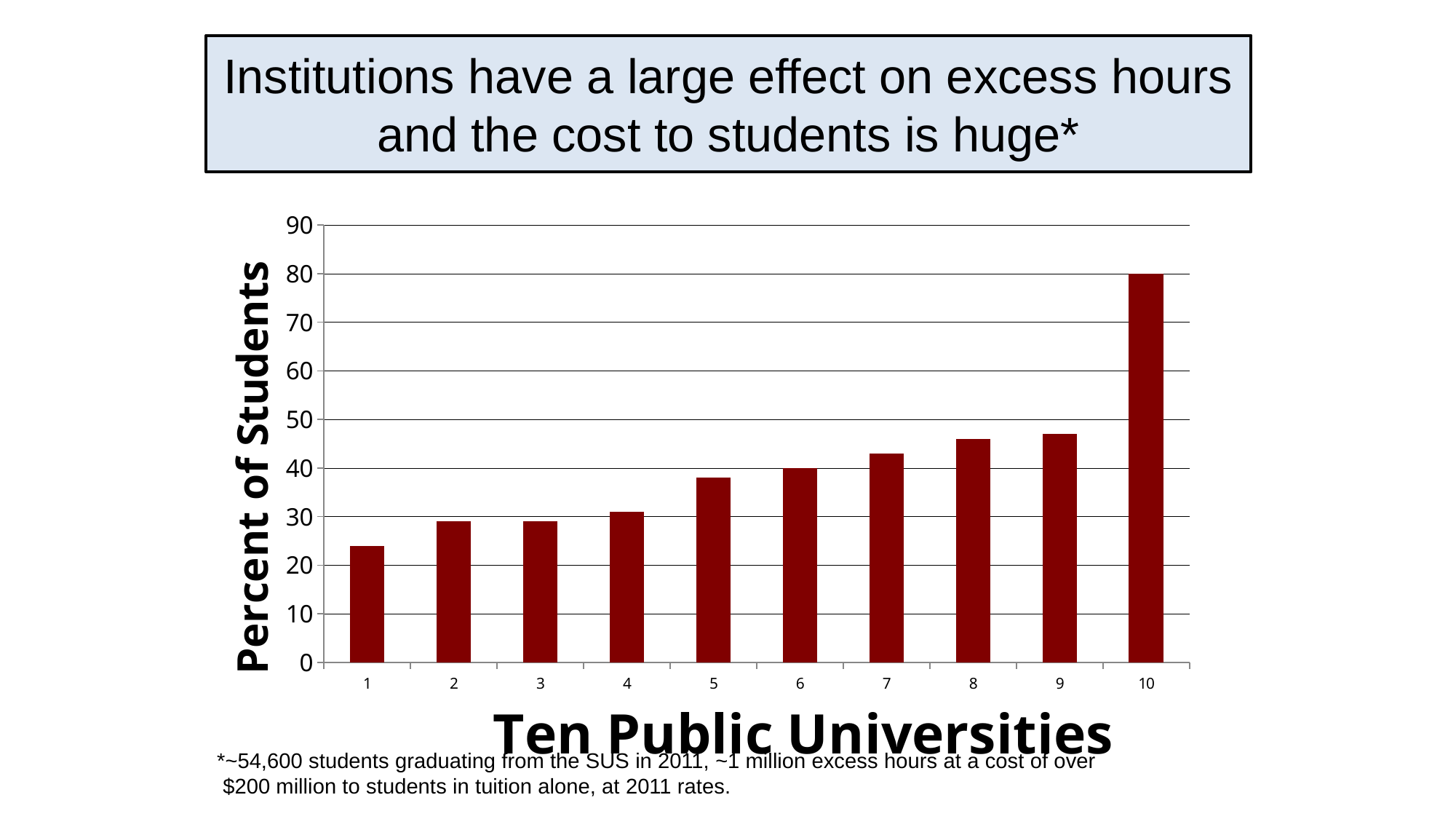
Which has a larger percent of students, university 7 or university 2? university 7 Which university has the lowest percent of students? 1 Is the value for university 10 greater or less than 70? greater What is the title of the vertical axis? Percent of Students How many universities (bars) are plotted in the chart? 10 What kind of chart is shown on the slide? bar chart Do the values generally rise or fall from university 1 to university 10? rise Is the value for university 5 greater or less than 30? greater Is the value for university 1 greater or less than 30? less What is the percent of students for university 10? 80 Which university has the highest percent of students? 10